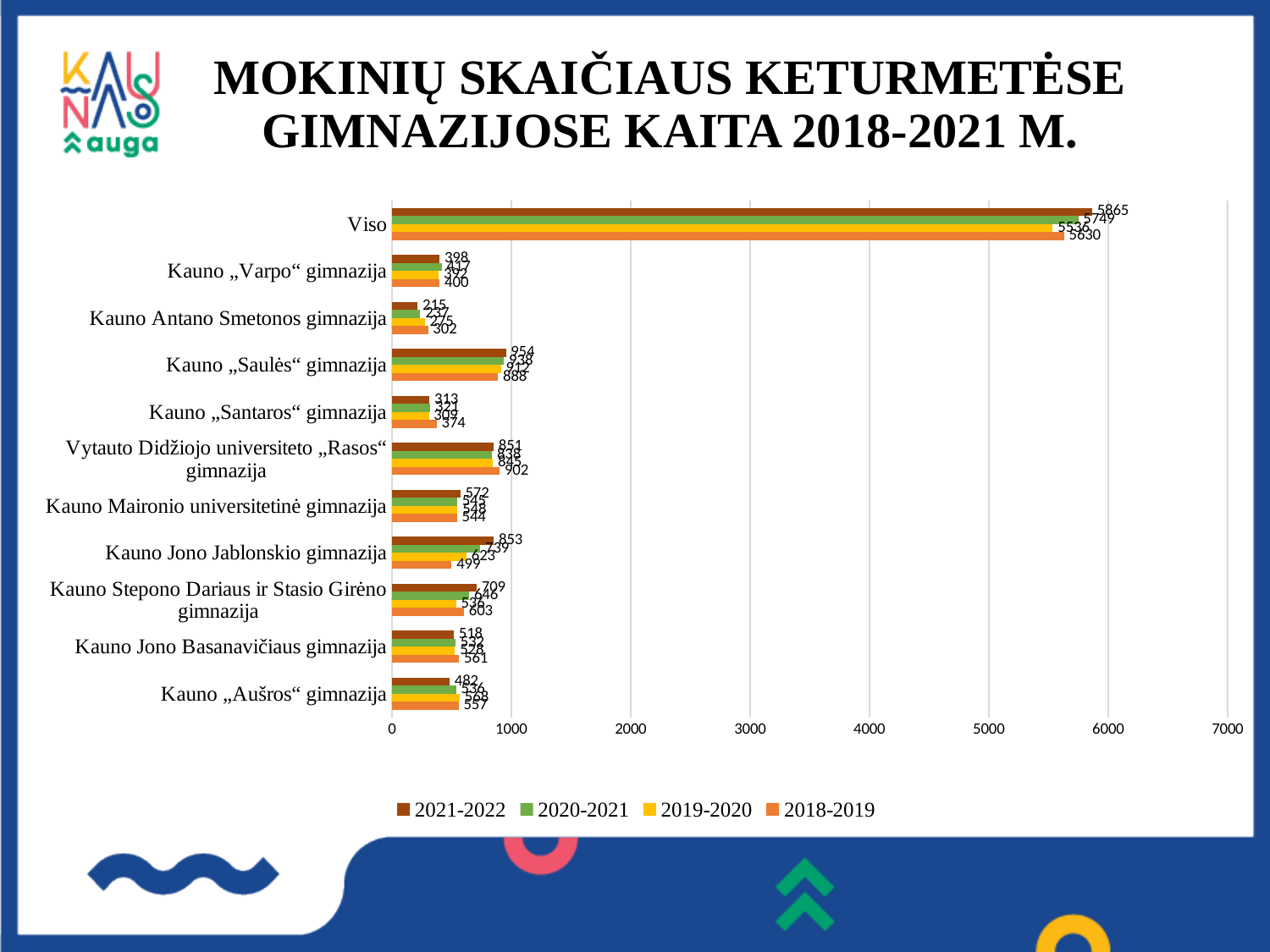
What kind of chart is shown on the slide? bar chart How many categories are plotted on the vertical axis? 11 Is the value for Viso in the 2021-2022 series greater or less than 5000? greater Does the value for Kauno Jono Jablonskio gimnazija rise or fall from 2018-2019 to 2021-2022? rise What is the value for Viso in the 2021-2022 series? 5865 Which is larger in the 2021-2022 series: Kauno „Saulės“ gimnazija or Vytauto Didžiojo universiteto „Rasos“ gimnazija? Kauno „Saulės“ gimnazija What is the difference between the 2021-2022 and 2018-2019 values for Kauno Jono Jablonskio gimnazija? 354 What is the value for Kauno Jono Jablonskio gimnazija in the 2018-2019 series? 499 What is the value for Kauno Antano Smetonos gimnazija in the 2021-2022 series? 215 Excluding Viso, which gymnasium has the highest value in the 2021-2022 series? Kauno „Saulės“ gimnazija Which gymnasium has the lowest value in the 2021-2022 series? Kauno Antano Smetonos gimnazija How many series does the legend list? 4